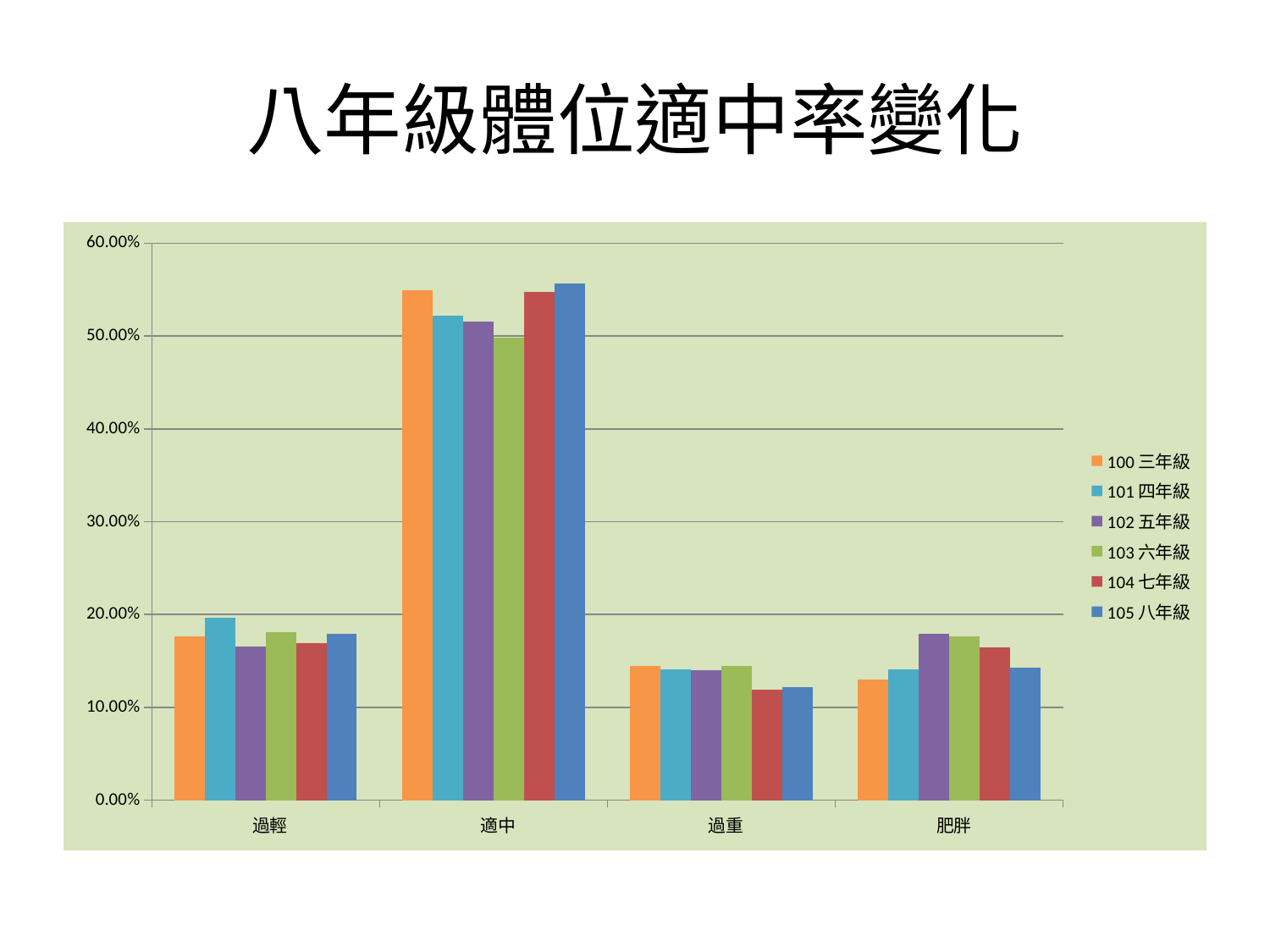
Is the value for 100 三年級 in the 適中 category greater or less than 50.00%? greater For 102 五年級, which is larger: the value for 肥胖 or the value for 過重? 肥胖 In the 肥胖 category, which series has the lowest value? 100 三年級 How many series does the legend list? 6 In the 適中 category, which series has the lowest value? 103 六年級 What is the title of the slide? 八年級體位適中率變化 What kind of chart is shown on the slide? bar chart How many categories are shown on the x axis? 4 In the 過輕 category, which series has the highest value? 101 四年級 Which category has the highest values across all series? 適中